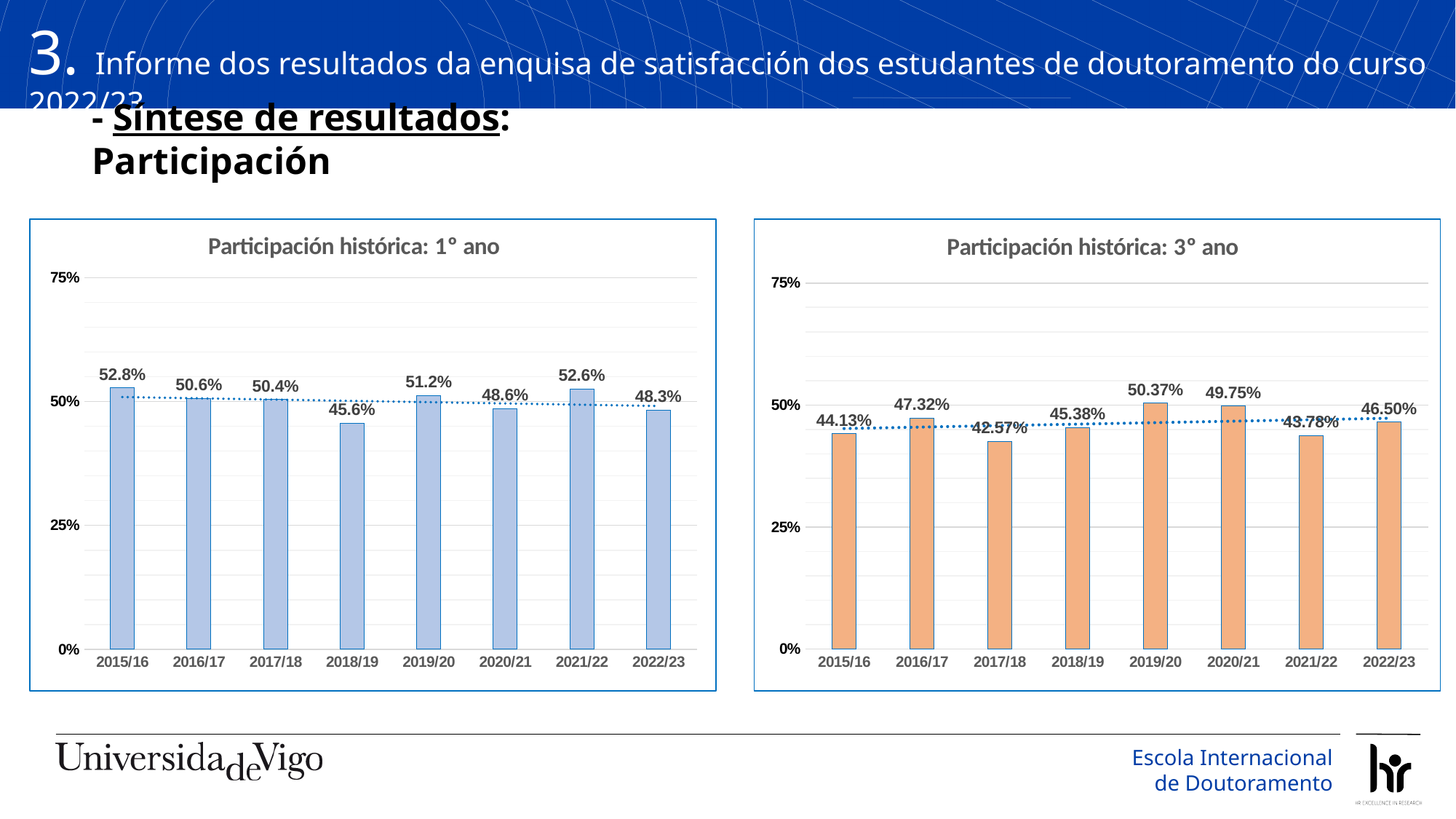
In the chart titled 'Participación histórica: 3° ano', what is the difference in percentage points between 2019/20 and 2017/18? 7.80 percentage points In the chart titled 'Participación histórica: 1° ano', which year has the higher participation, 2019/20 or 2020/21? 2019/20 In the chart titled 'Participación histórica: 3° ano', what is the participation value for 2022/23? 46.50% What type of chart is 'Participación histórica: 3° ano'? Bar chart In the chart titled 'Participación histórica: 3° ano', which year has the highest participation? 2019/20 In the chart titled 'Participación histórica: 1° ano', what is the participation value for 2018/19? 45.6% In the chart titled 'Participación histórica: 3° ano', which year has the lowest participation? 2017/18 In the chart titled 'Participación histórica: 1° ano', what is the difference in percentage points between 2015/16 and 2022/23? 4.5 percentage points In the chart titled 'Participación histórica: 3° ano', is the value for 2021/22 greater or less than 50%? less How many academic years are shown in the chart titled 'Participación histórica: 1° ano'? 8 What colour are the bars in the chart titled 'Participación histórica: 3° ano'? Orange In the chart titled 'Participación histórica: 1° ano', which year has the lowest participation? 2018/19